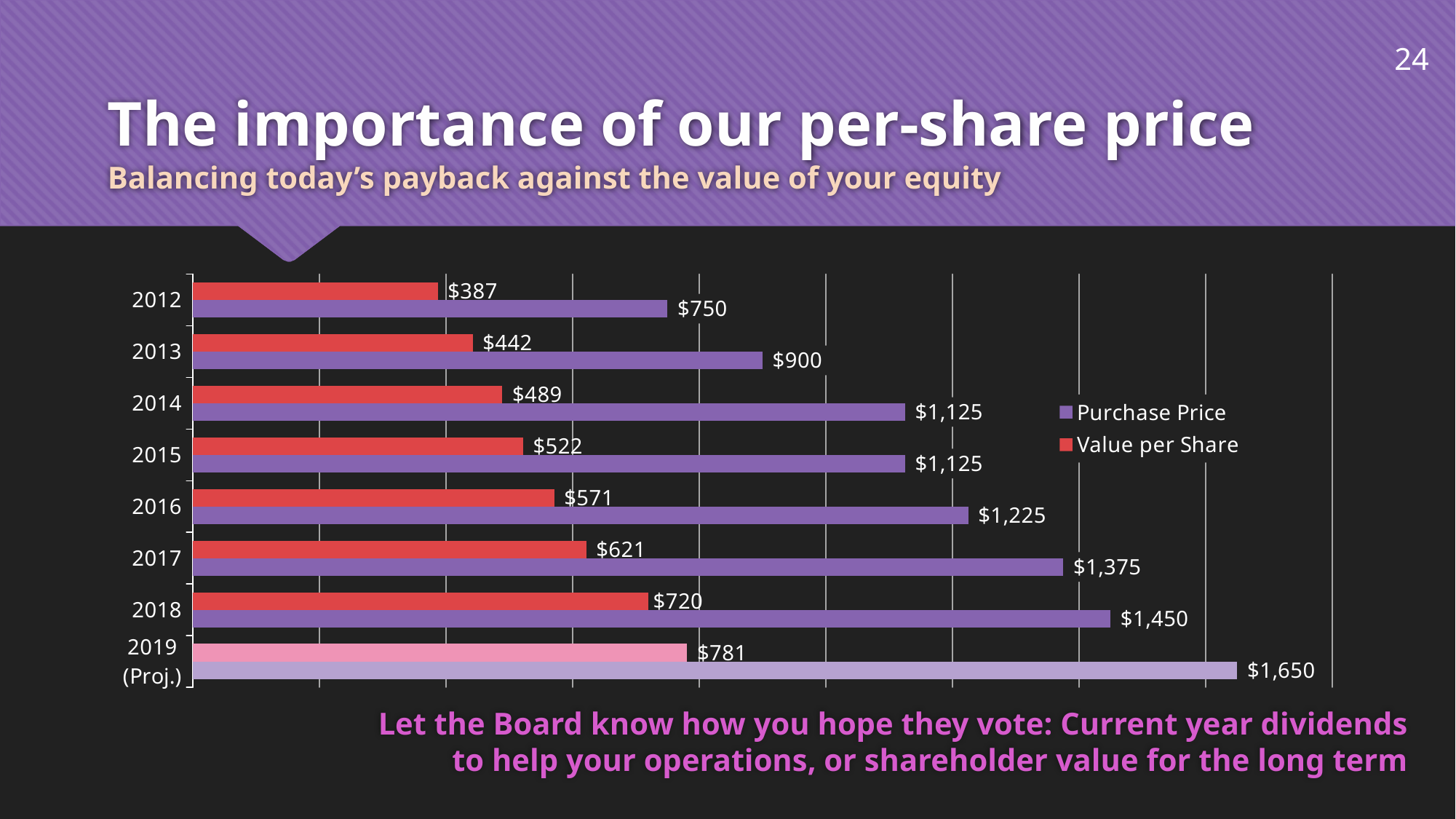
Which series is shown in purple in the legend? Purchase Price What is the Value per Share for 2017? $621 What kind of chart is shown on the slide? Bar chart How many years are shown on the chart? 8 How many series does the legend list? 2 Which year has the lowest Value per Share? 2012 What is the Purchase Price for 2014? $1,125 Does the Value per Share rise or fall from 2012 to 2019 (Proj.)? Rise Which year has the highest Purchase Price? 2019 (Proj.) What is the projected Purchase Price for 2019 (Proj.)? $1,650 What is the difference between the Purchase Price and the Value per Share in 2018? $730 Which is larger: the Purchase Price in 2013 or the Value per Share in 2019 (Proj.)? Purchase Price in 2013